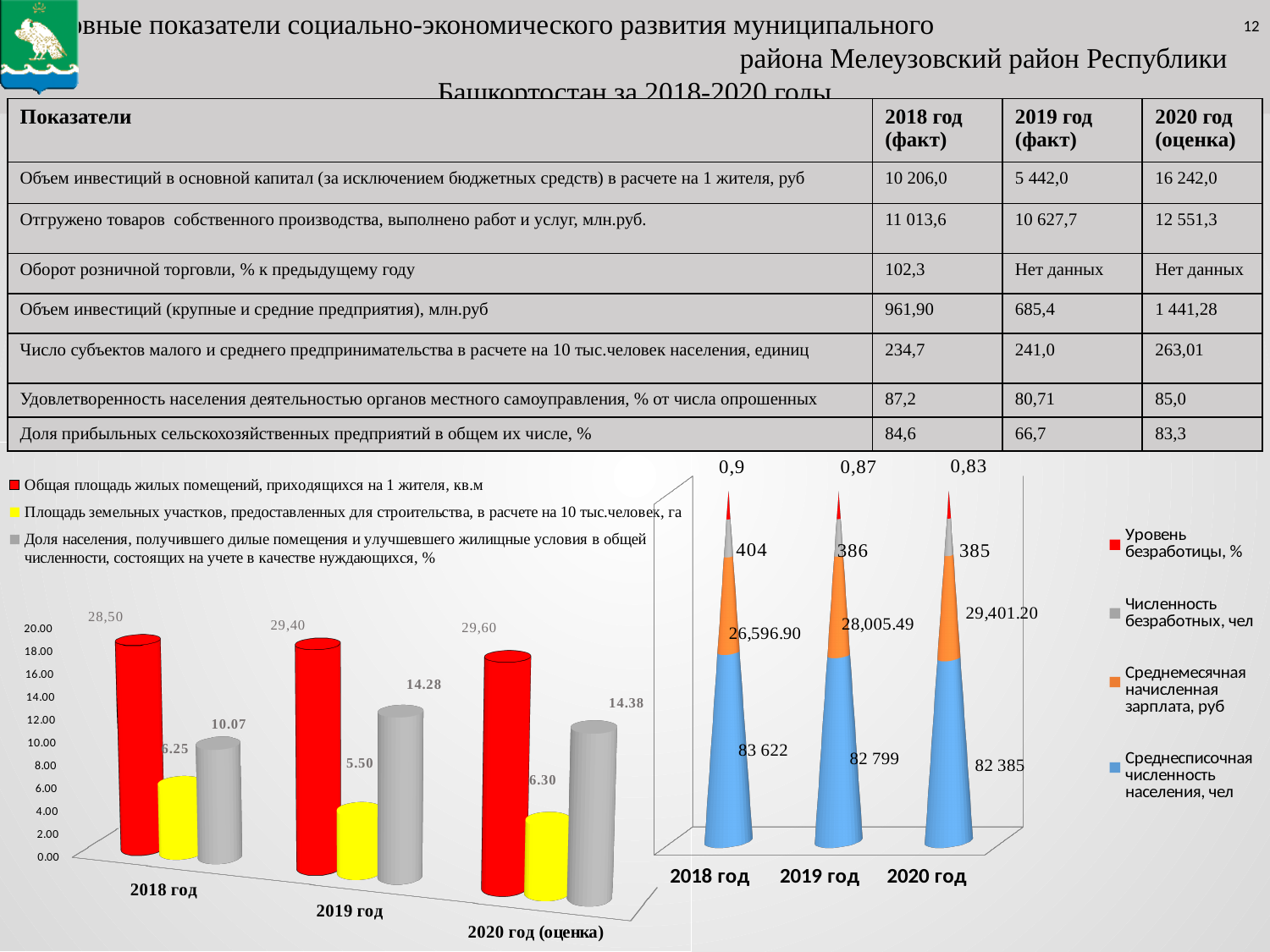
In the right chart, what is the value of 'Среднемесячная начисленная зарплата, руб' for 2020 год? 29,401.20 In the left bar chart, what is the value of 'Доля населения, получившего жилые помещения...' for 2020 год (оценка)? 14.38 How many series does the legend of the left bar chart list? 3 In the right chart, what is the value of 'Численность безработных, чел' for 2018 год? 404 In the left bar chart, what is the difference between the 2019 and 2018 values of the grey series 'Доля населения, получившего жилые помещения...'? 4.21 What kind of chart is the left chart on the slide? Bar chart In the right chart, what is the difference between 'Среднесписочная численность населения, чел' in 2018 год and 2020 год? 1 237 In the left bar chart, does the red series 'Общая площадь жилых помещений' rise or fall from 2018 to 2020? Rises In the left bar chart, in which year is 'Площадь земельных участков, предоставленных для строительства' lowest? 2019 год In the right chart, does 'Среднесписочная численность населения, чел' rise or fall from 2018 to 2020? Falls In the left bar chart, what is the value of 'Общая площадь жилых помещений, приходящихся на 1 жителя, кв.м' for 2019 год? 29,40 How many series does the legend of the right chart list? 4